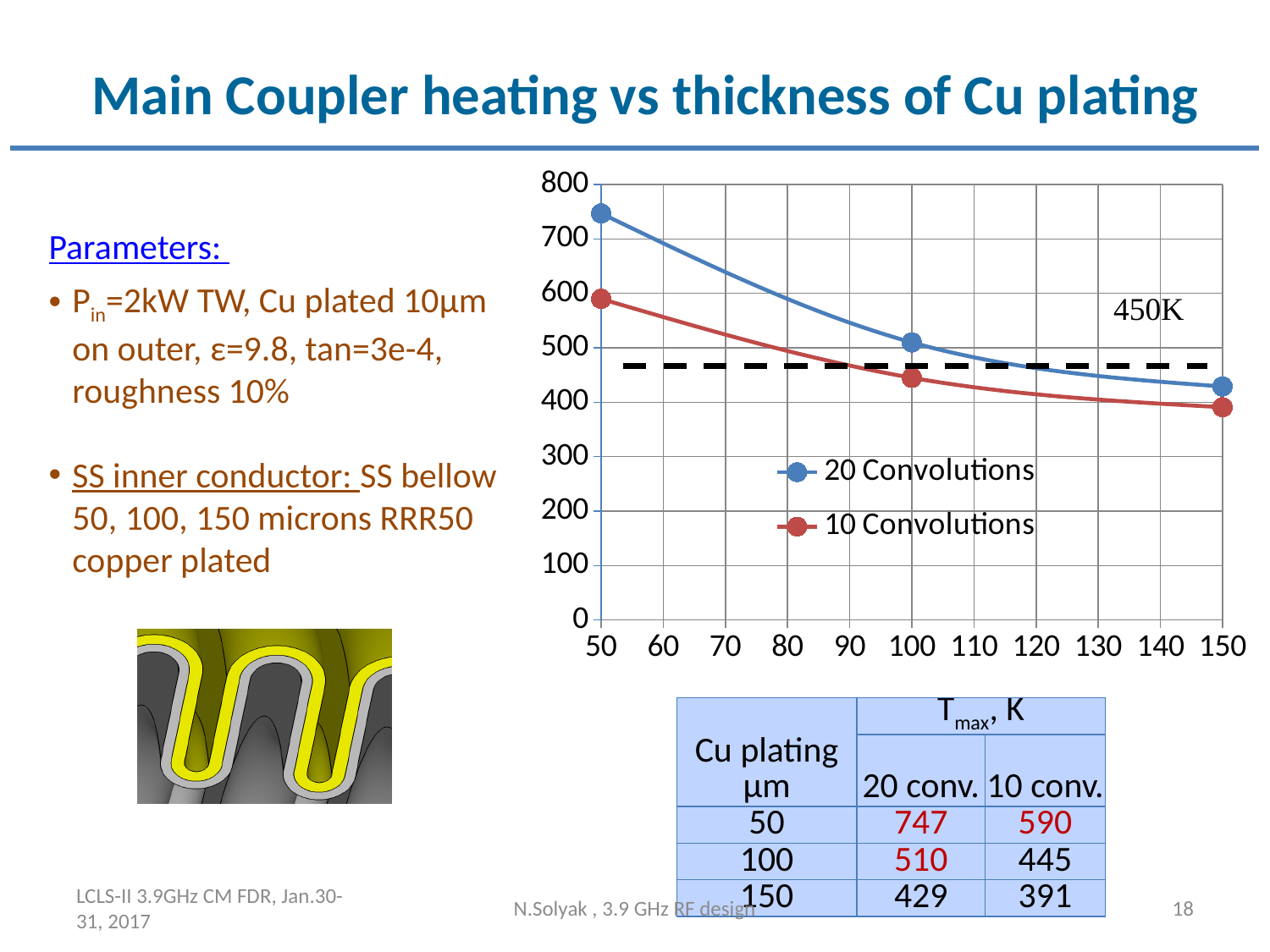
Is the value of the 10 Convolutions series at x = 150 greater or less than 400? less How many data points are plotted for the 20 Convolutions series? 3 How many series does the chart legend list? 2 What is the Tmax value for 10 Convolutions at 100 µm Cu plating, as printed in the table? 445 Is the value of the 20 Convolutions series at x = 100 greater or less than 500? greater Which series has the higher value at x = 50, 20 Convolutions or 10 Convolutions? 20 Convolutions At which Cu plating thickness is the 20 Convolutions value highest? 50 What temperature level does the dashed horizontal line on the chart mark? 450K What is the Tmax value for 20 Convolutions at 50 µm Cu plating, as printed in the table? 747 What is the difference between the 20 conv. and 10 conv. Tmax values at 150 µm Cu plating? 38 Do the values of the 20 Convolutions series rise or fall as the x axis increases from 50 to 150? fall What kind of chart is shown on the slide? line chart